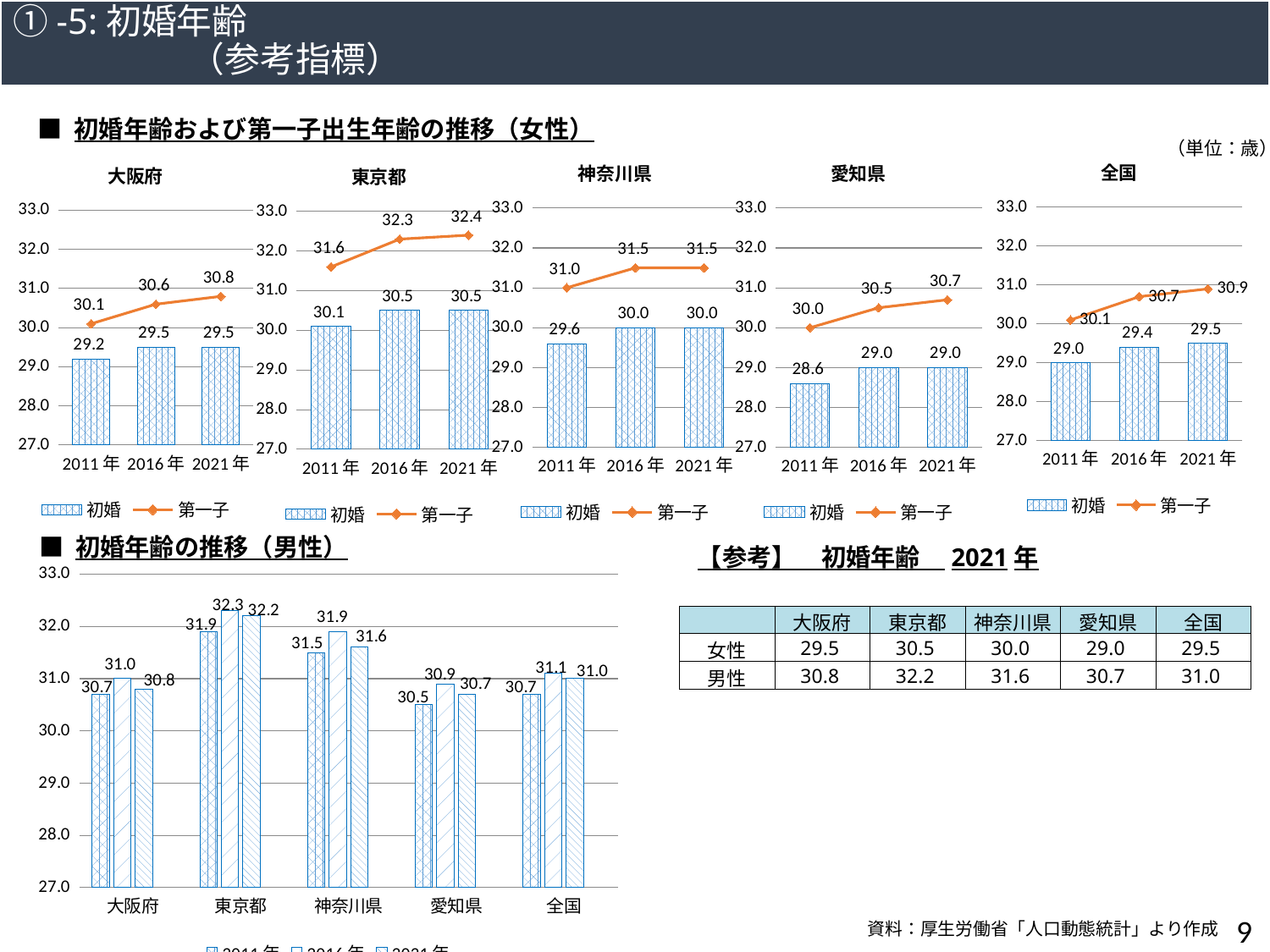
In the 神奈川県 chart for women, which year has the lowest 初婚 value? 2011年 In the 初婚年齢の推移（男性） chart, what is the highest value shown? 32.3 In the 初婚年齢の推移（男性） chart, how many regions are shown on the x axis? 5 In the 愛知県 chart for women, which is larger: the 第一子 value in 2021年 or the 初婚 value in 2021年? 第一子 (30.7) What kind of chart is the 初婚年齢の推移（男性） chart? bar chart In the 全国 chart for women, what is the 第一子 value for 2016年? 30.7 In the 東京都 chart for women, does the 第一子 line rise or fall from 2011年 to 2021年? rise In the 初婚年齢の推移（男性） chart, is the lowest bar for 愛知県 greater or less than 31.0? less In the 東京都 chart for women (初婚年齢および第一子出生年齢の推移（女性）), what is the 第一子 value for 2021年? 32.4 How many series does the legend list in each of the women's charts? 2 In the 愛知県 chart for women, what is the 初婚 value for 2011年? 28.6 In the 大阪府 chart for women, what is the difference between the 第一子 value and the 初婚 value in 2021年? 1.3